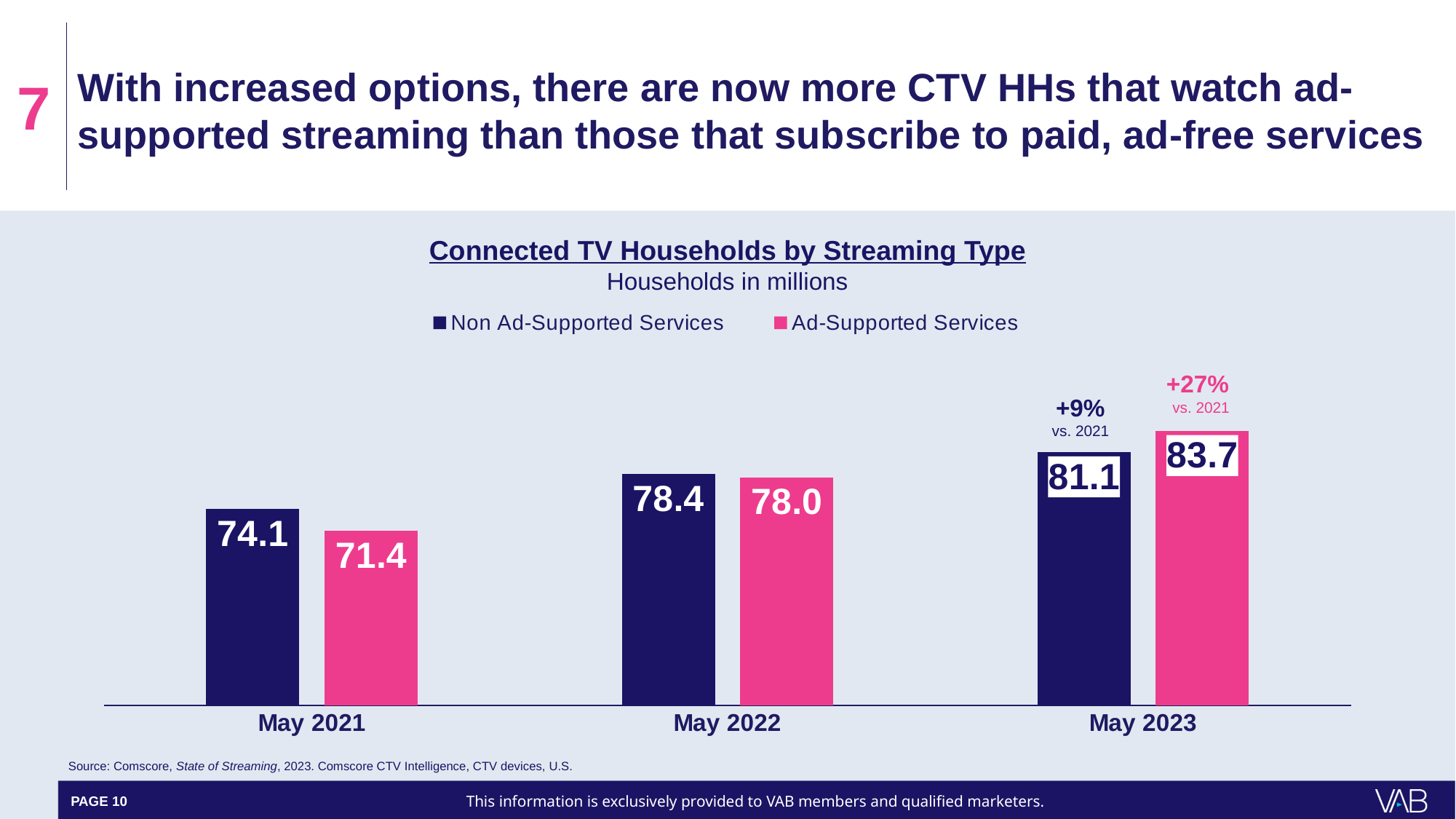
Which period has the lowest value for Non Ad-Supported Services? May 2021 In May 2021, which is larger: Non Ad-Supported Services or Ad-Supported Services? Non Ad-Supported Services Do the values for Ad-Supported Services rise or fall from May 2021 to May 2023? Rise What is the value for Ad-Supported Services in May 2022? 78.0 How many time periods are shown on the x axis? 3 How many series does the legend list? 2 What is the value for Ad-Supported Services in May 2023? 83.7 What kind of chart is shown on the slide? Bar chart What is the value for Non Ad-Supported Services in May 2021? 74.1 What is the difference between Non Ad-Supported Services in May 2021 and May 2023? 7.0 Which period has the highest value for Ad-Supported Services? May 2023 What is the difference between Ad-Supported Services and Non Ad-Supported Services in May 2023? 2.6